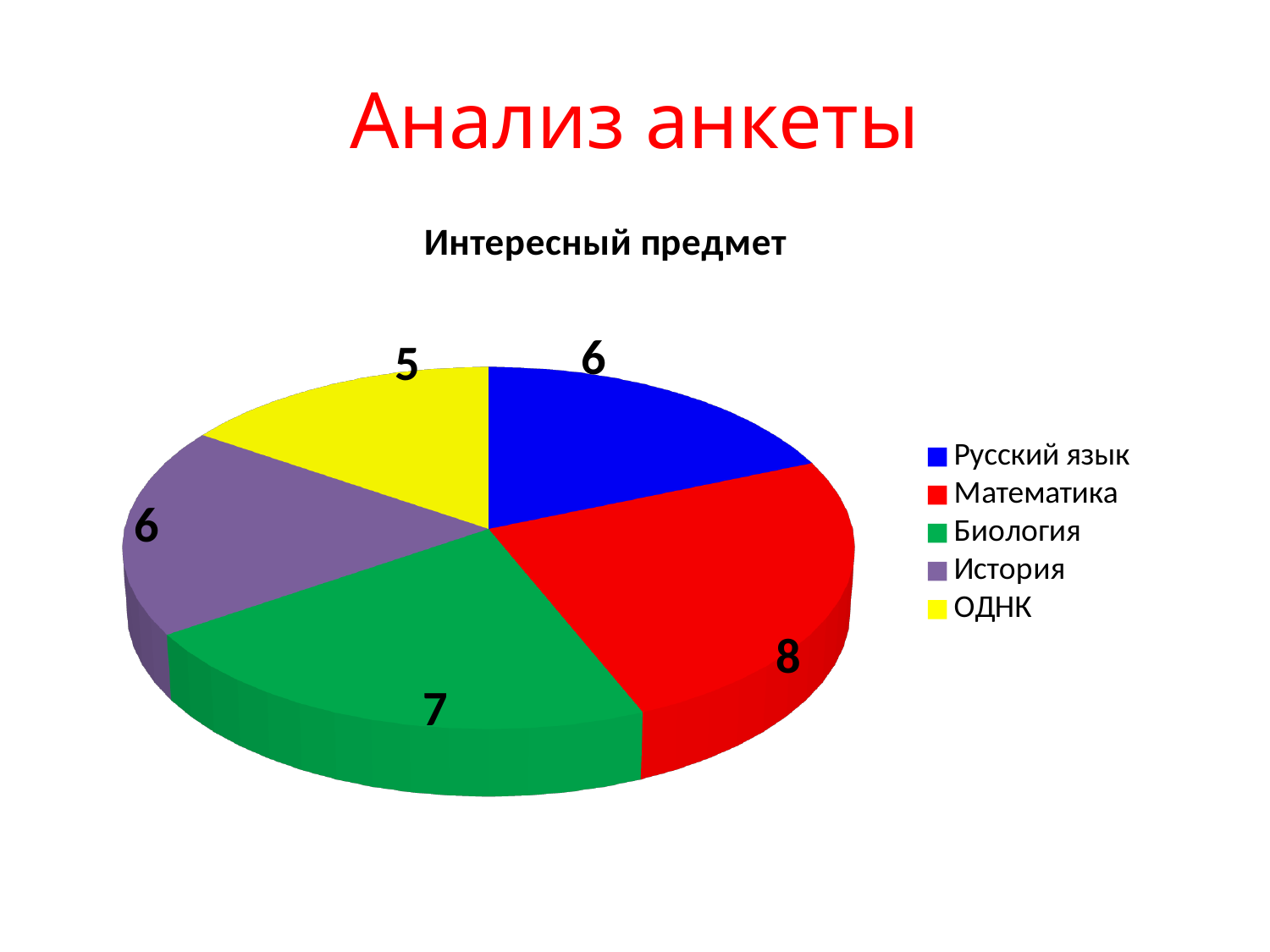
What is the value for ОДНК? 5 What kind of chart is shown on the slide? pie chart Which is larger, the value for Биология or the value for История? Биология Which category has the smallest slice? ОДНК How many categories does the pie chart have? 5 What is the value for Математика? 8 What is the title of the chart? Интересный предмет What is the difference between the values for Математика and ОДНК? 3 What is the value for Биология? 7 What is the value for Русский язык? 6 Which category has the largest slice? Математика What share of the pie does Математика represent? 25%